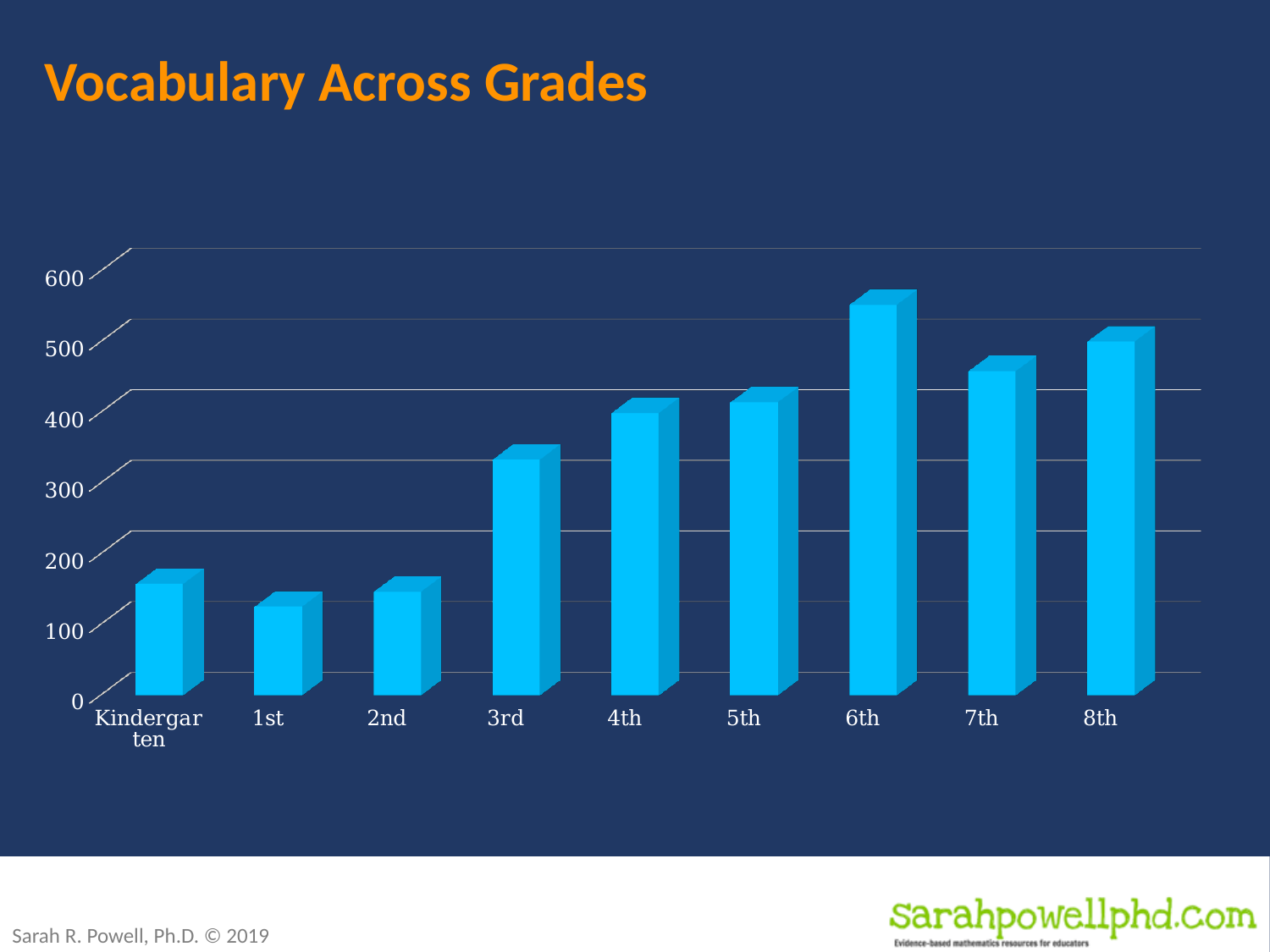
What is the title of the chart? Vocabulary Across Grades Is the value for 6th grade greater or less than 500? greater Is the value for 7th grade greater or less than 500? less Do the values generally rise or fall from Kindergarten to 8th grade? rise What kind of chart is shown on the slide? bar chart Which is larger, the value for 6th grade or the value for 8th grade? 6th Is the value for 3rd grade greater or less than 400? less Which grade has the lowest bar? 1st Which grade has the highest bar? 6th How many grade categories are shown on the x axis? 9 Which is larger, the value for 2nd grade or the value for 3rd grade? 3rd